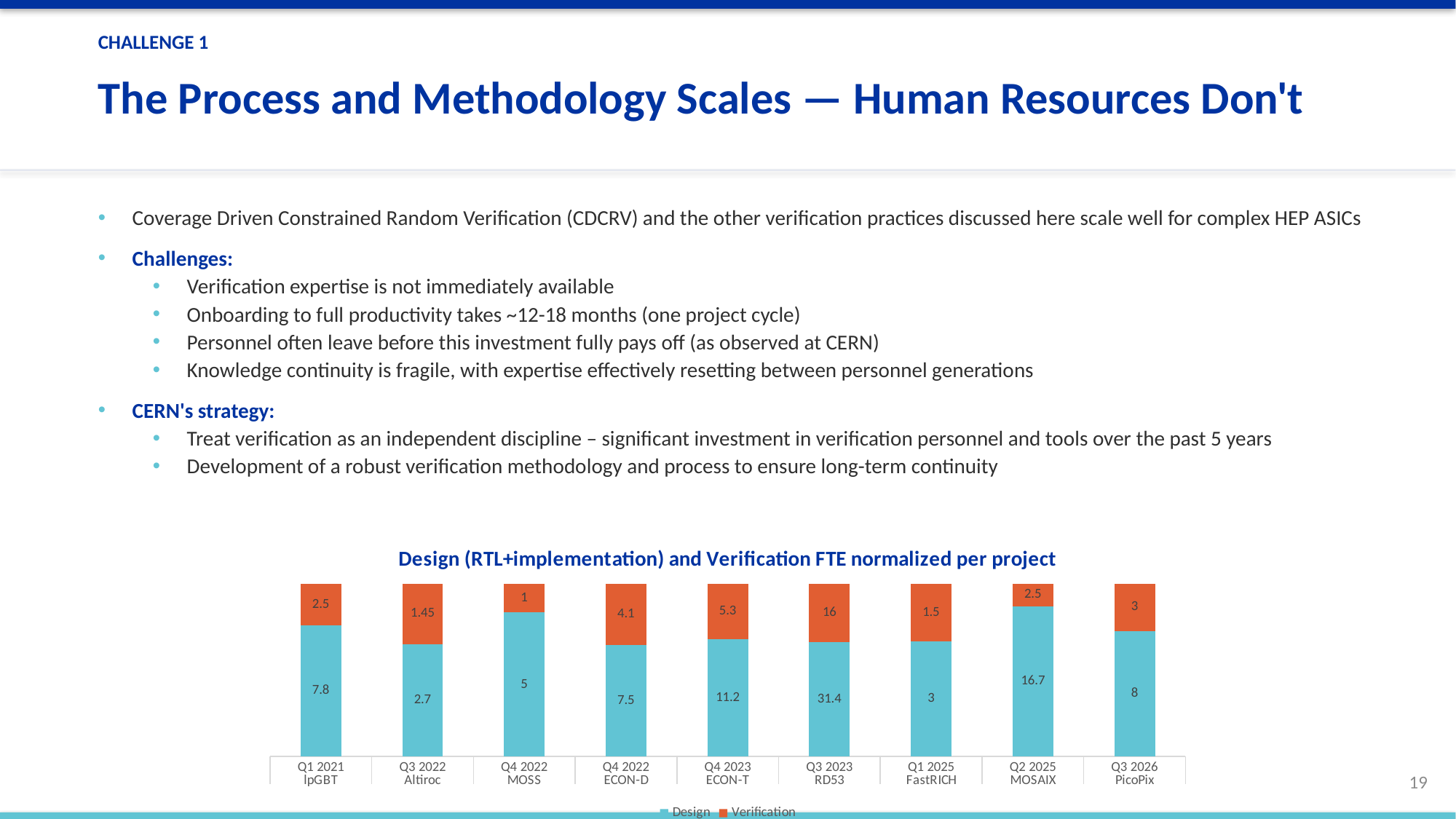
Which is larger, the Design FTE value for ECON-T or for ECON-D? ECON-T Which project has the lowest Verification FTE value? MOSS What is the Verification FTE value for Altiroc? 1.45 What is the Verification FTE value for ECON-T? 5.3 How many projects are shown on the x axis of the chart? 9 What is the Design FTE value for MOSAIX? 16.7 How many series does the chart legend list? 2 Which project has the highest Design FTE value? RD53 What is the total of the Design and Verification FTE values for lpGBT? 10.3 What is the difference between the Design and Verification FTE values for RD53? 15.4 What is the Design FTE value for RD53? 31.4 What kind of chart is shown on the slide? Stacked bar chart